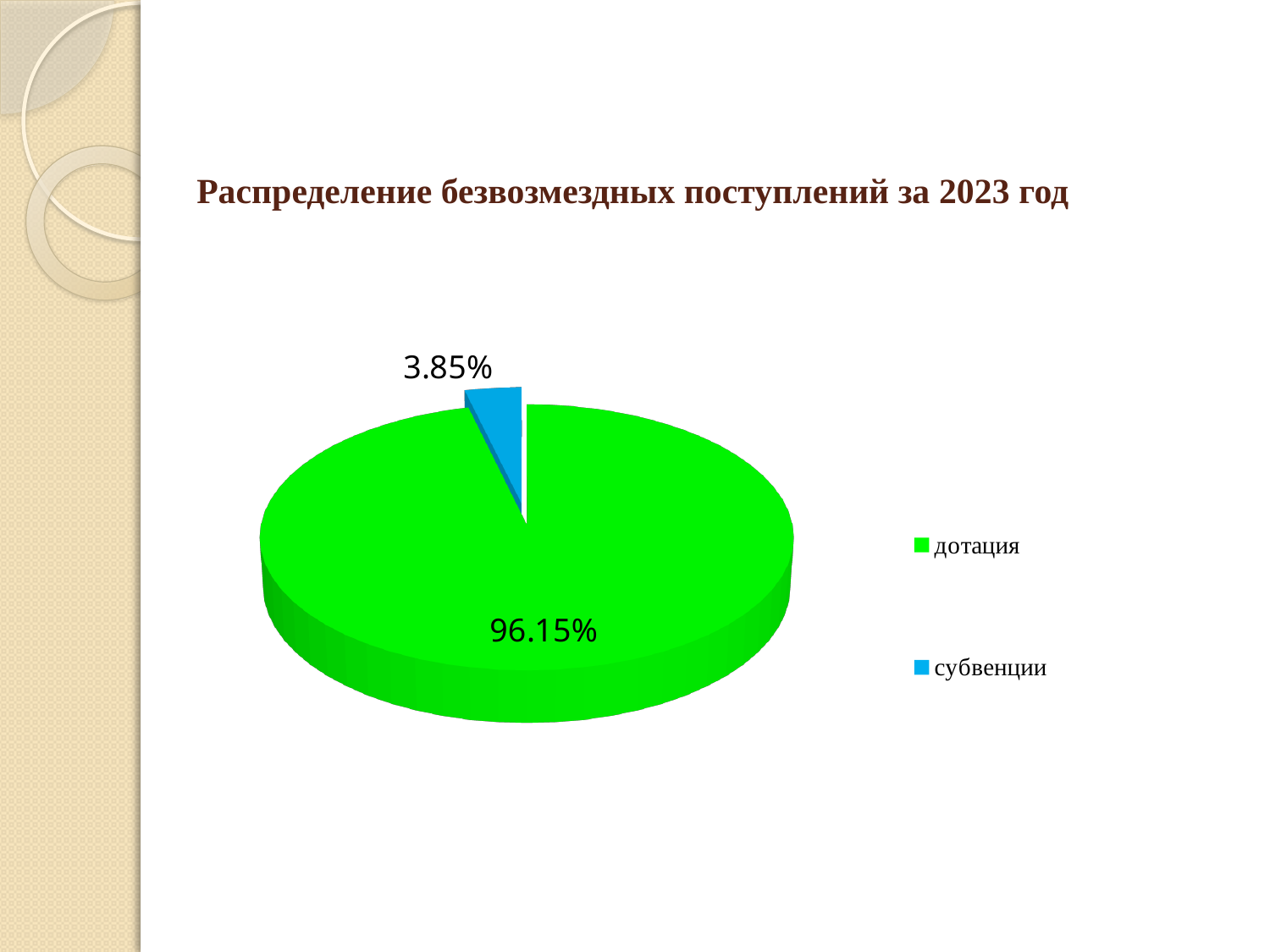
What colour is the slice for субвенции? blue What is the title of the chart? Распределение безвозмездных поступлений за 2023 год Which category has the largest share of the pie? дотация Which is larger, the share for дотация or the share for субвенции? дотация What is the difference in percentage points between the share for дотация and the share for субвенции? 92.30 What share of the pie does дотация have? 96.15% How many entries does the legend list? 2 What share of the pie does субвенции have? 3.85% What kind of chart is shown on the slide? pie chart Which category has the smallest share of the pie? субвенции How many categories does the pie chart show? 2